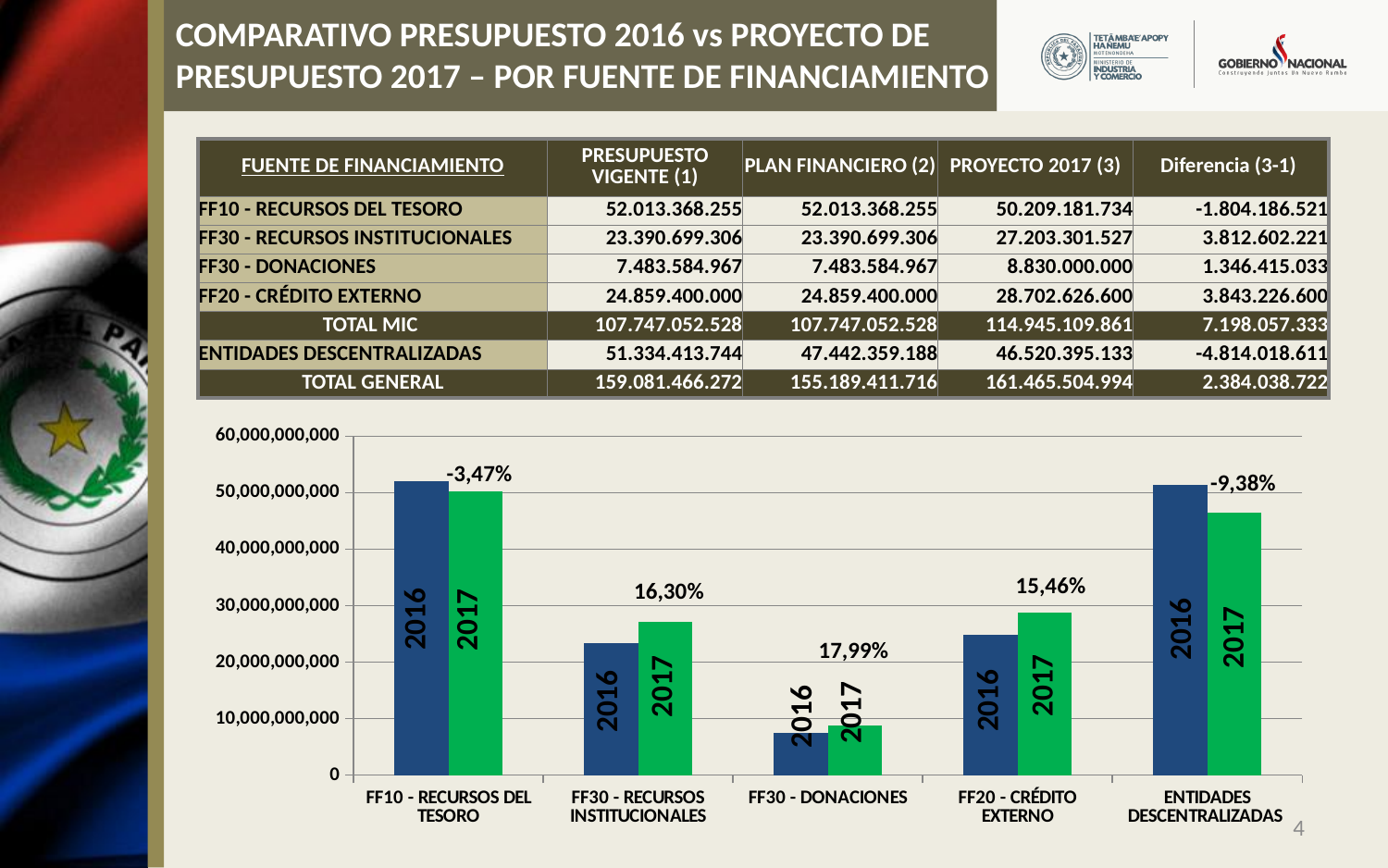
Is the 2017 value for FF30 - DONACIONES greater or less than 10,000,000,000? less What percentage label is shown above the bars for FF20 - CRÉDITO EXTERNO? 15,46% Which colour are the 2017 bars in the chart? green Which category has the lowest bars in the chart? FF30 - DONACIONES For FF20 - CRÉDITO EXTERNO, which bar is taller, 2016 or 2017? 2017 Is the 2016 value for FF10 - RECURSOS DEL TESORO greater or less than 40,000,000,000? greater What percentage label is shown above the bars for FF10 - RECURSOS DEL TESORO? -3,47% What percentage label is shown above the bars for ENTIDADES DESCENTRALIZADAS? -9,38% How many categories are shown along the x axis of the chart? 5 What type of chart is shown on the slide? bar chart What percentage label is shown above the bars for FF30 - DONACIONES? 17,99% Is the 2017 value for ENTIDADES DESCENTRALIZADAS greater or less than 40,000,000,000? greater